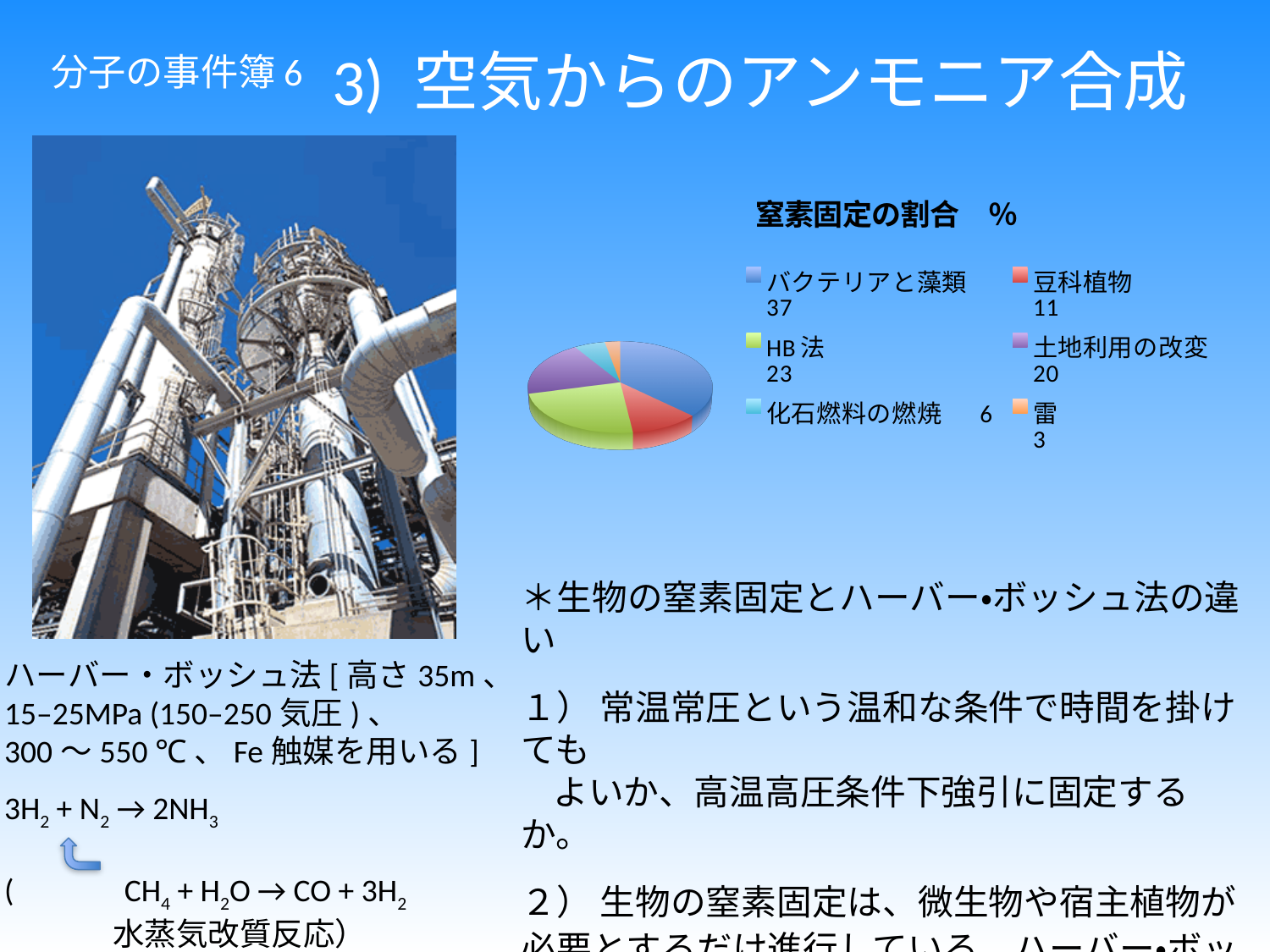
What is the value for 土地利用の改変 in the pie chart? 20 How many categories does the pie chart have? 6 Which category has the smallest share of the pie chart? 雷 What is the value for 雷 in the pie chart? 3 Which category has the largest share of the pie chart? バクテリアと藻類 What is the title of the pie chart? 窒素固定の割合 % What is the combined value of 豆科植物 and 土地利用の改変? 31 What kind of chart is shown on the slide? pie chart What is the value for バクテリアと藻類 in the pie chart? 37 What is the value for HB法 in the pie chart? 23 What is the difference between the values for バクテリアと藻類 and HB法? 14 Which is larger, the value for 豆科植物 or the value for 化石燃料の燃焼? 豆科植物